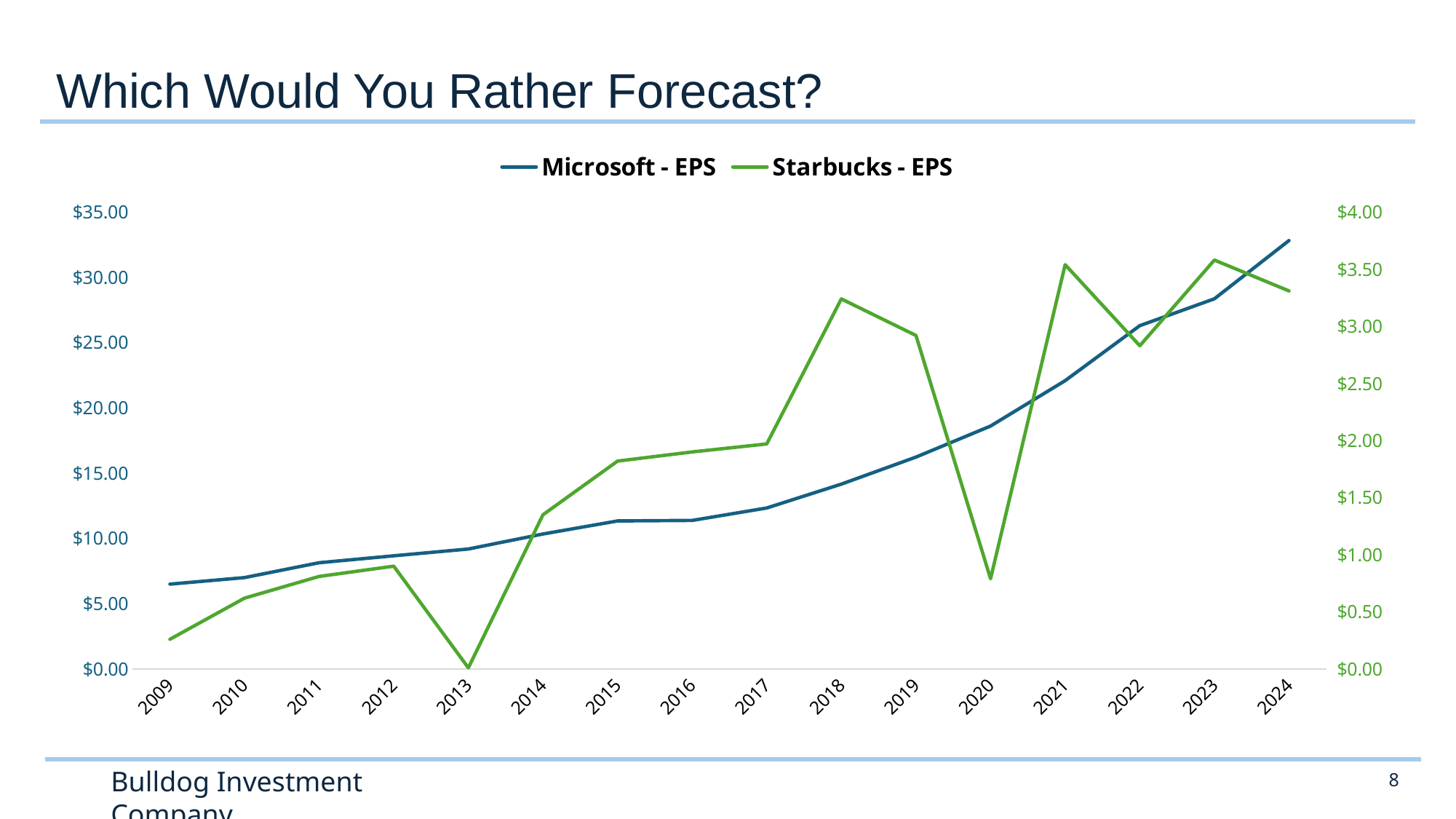
Is the Microsoft - EPS value for 2024 greater or less than $30.00? greater In which year is Microsoft - EPS highest? 2024 In which year is Starbucks - EPS lowest? 2013 Is the Starbucks - EPS value for 2018 greater or less than $3.00? greater Does the Microsoft - EPS line generally rise or fall from 2009 to 2024? Rise How many years are plotted along the x axis? 16 Is the Microsoft - EPS value for 2009 greater or less than $10.00? less What kind of chart is shown on the slide? Line chart Which year has the larger Microsoft - EPS value, 2016 or 2022? 2022 In which year is Microsoft - EPS lowest? 2009 How many series does the legend list? 2 What colour is the Starbucks - EPS line? Green